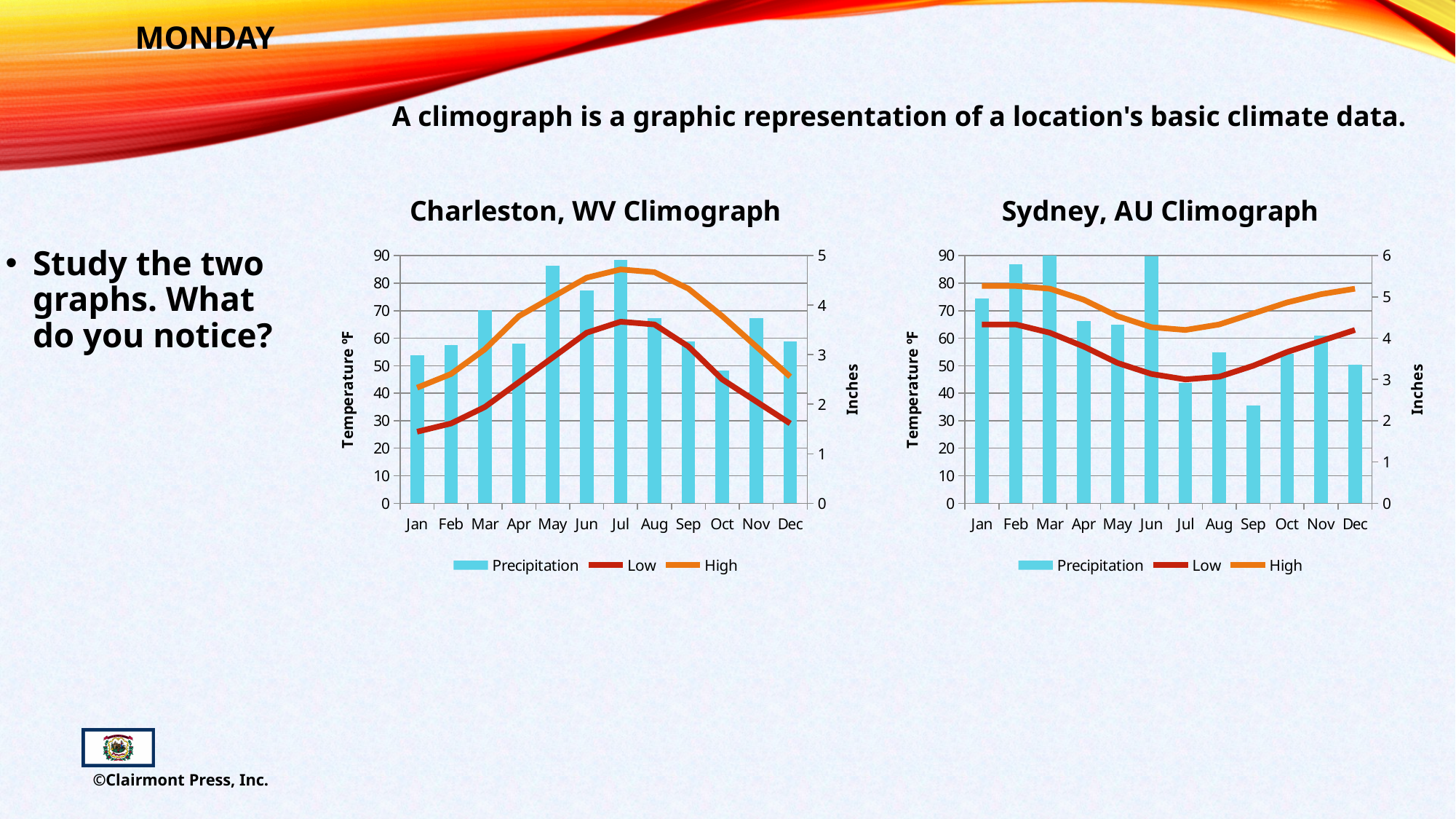
In the Sydney, AU Climograph, does the High temperature rise or fall from Jan to Jul? fall In the Charleston, WV Climograph, is the High temperature for Jul greater or less than 80? greater How many months are shown on the x axis of the Charleston, WV Climograph? 12 In the Charleston, WV Climograph, is the precipitation value for Jul greater or less than 4 inches? greater In the Charleston, WV Climograph, is the Low temperature for Jan greater or less than 30? less How many series does the legend of the Sydney, AU Climograph list? 3 In the Charleston, WV Climograph, which is larger, the precipitation for Jul or for Jan? Jul In the Charleston, WV Climograph, does the High temperature rise or fall from Jan to Jul? rise In the Sydney, AU Climograph, which month has the lowest precipitation? Sep What type of chart is the Charleston, WV Climograph? Combination bar and line chart